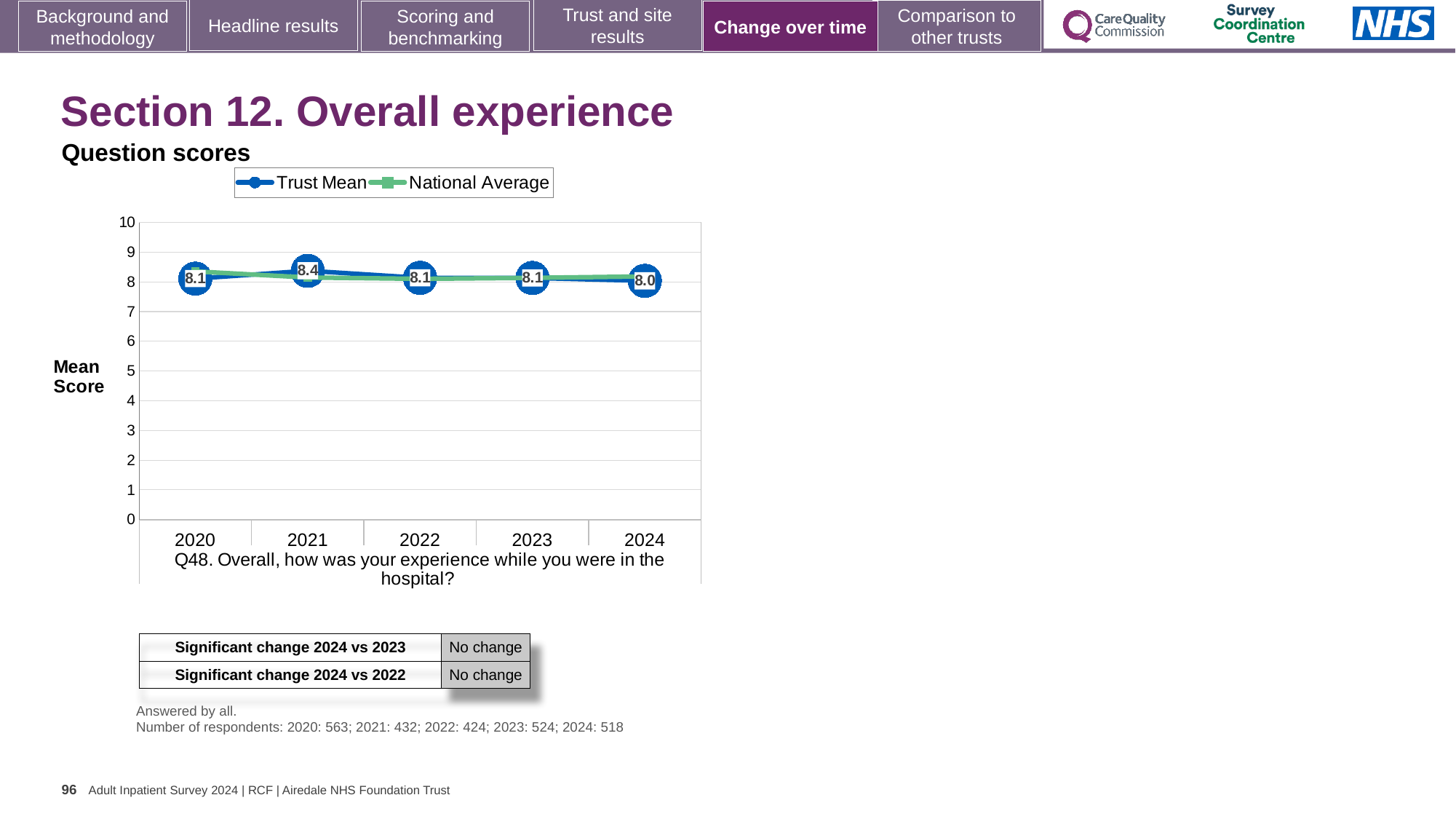
In which year is the Trust Mean score highest? 2021 In which year is the Trust Mean score lowest? 2024 How many series does the legend list? 2 What is the Trust Mean score for 2020? 8.1 What is the difference between the Trust Mean score in 2021 and in 2024? 0.4 Which is larger, the Trust Mean score in 2021 or in 2023? 2021 How many years are plotted on the x axis? 5 What is the Trust Mean score for 2021? 8.4 Is the National Average value for 2022 greater or less than 7? greater What kind of chart is shown on the slide? Line chart What is the Trust Mean score for 2024? 8.0 Does the Trust Mean score rise or fall from 2021 to 2024? Fall